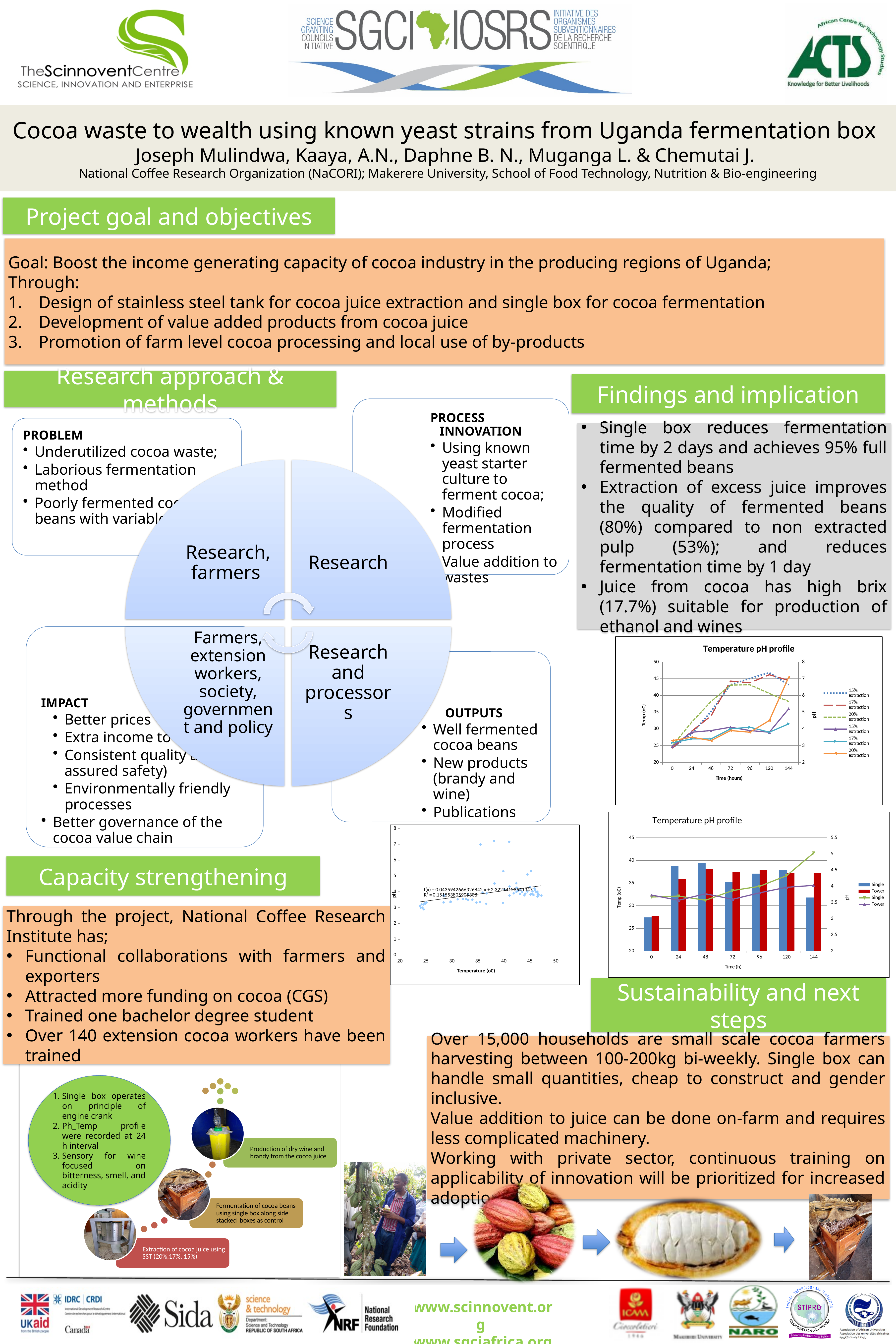
In the bottom-right 'Temperature pH profile' chart, is the Single temperature bar at 48 h greater or less than 35? greater In the bottom-right 'Temperature pH profile' chart, which temperature bar is taller at 144 h, Single or Tower? Tower What kind of chart is the chart in the middle of the slide that plots pH against Temperature (oC)? scatter chart In the bottom-right 'Temperature pH profile' chart, does the Single pH line rise or fall from 0 h to 144 h? rises What is the x-axis title of the top-right 'Temperature pH profile' line chart? Time (hours) How many series does the legend of the bottom-right 'Temperature pH profile' chart list? 4 How many series does the legend of the top-right 'Temperature pH profile' line chart list? 6 In the bottom-right 'Temperature pH profile' chart, at which time is the Single temperature bar lowest? 0 In the middle scatter chart of pH against Temperature (oC), does the fitted trend line rise or fall as temperature increases? rises What kind of chart is the 'Temperature pH profile' chart at the top right of the slide? line chart In the bottom-right 'Temperature pH profile' chart, is the Single temperature bar at 0 h greater or less than 30? less How many time points are marked on the x axis of the top-right 'Temperature pH profile' line chart? 7